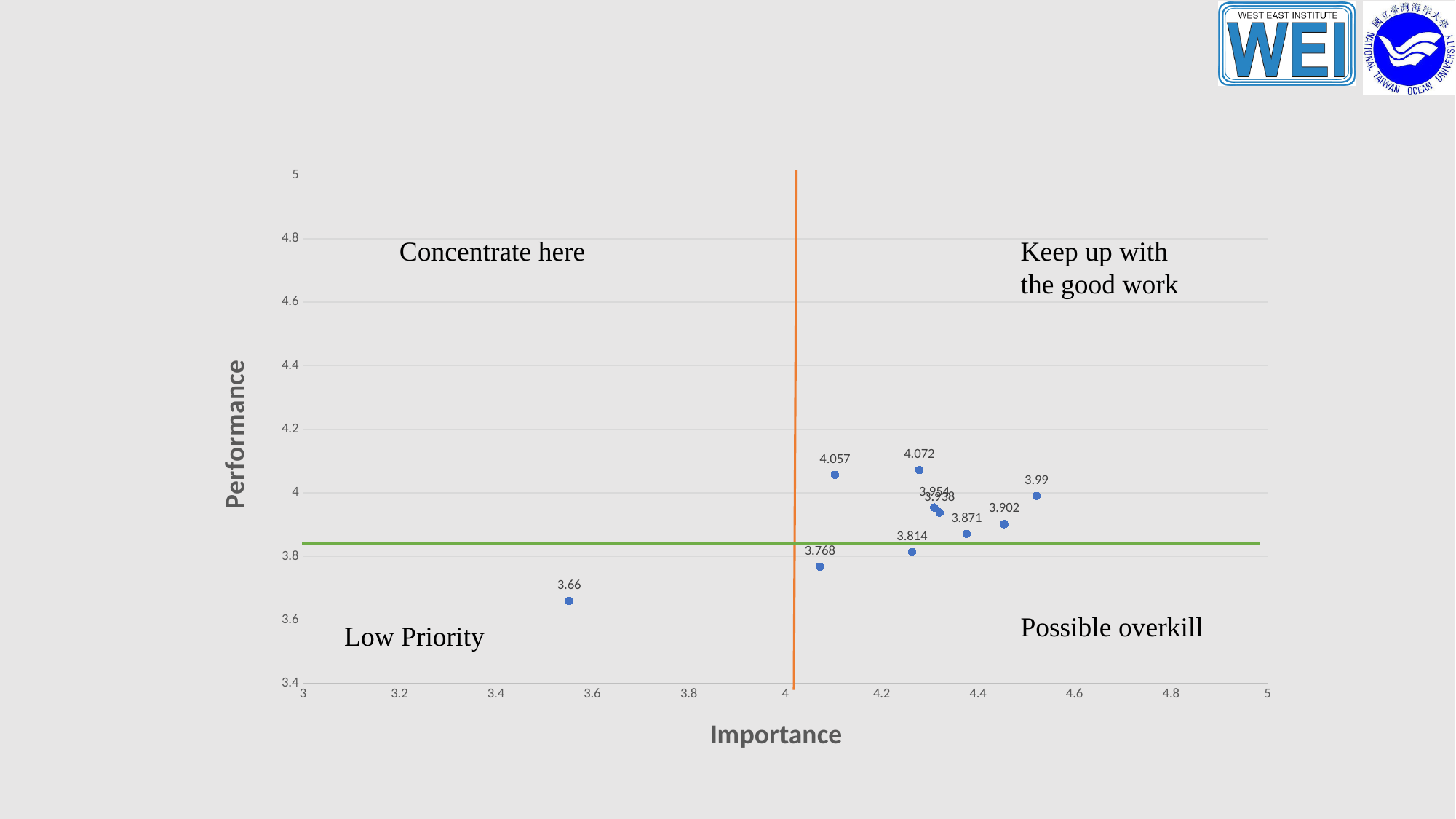
What is the label of the vertical axis of the chart? Performance What is the label of the horizontal axis of the chart? Importance What is the highest performance value labelled on the chart? 4.072 What is the lowest performance value labelled on the chart? 3.66 How many data points lie in the 'Low Priority' quadrant? 1 Which is larger, the point labelled 4.057 or the point labelled 3.99? 4.057 What is the difference between the highest labelled value (4.072) and the lowest labelled value (3.66)? 0.412 What kind of chart is shown on the slide? scatter chart Is the importance value of the point labelled 3.66 greater or less than 3.8? less How many data points lie below the green horizontal line? 3 Is the importance value of the point labelled 3.99 greater or less than 4.4? greater How many data points are plotted on the chart? 10